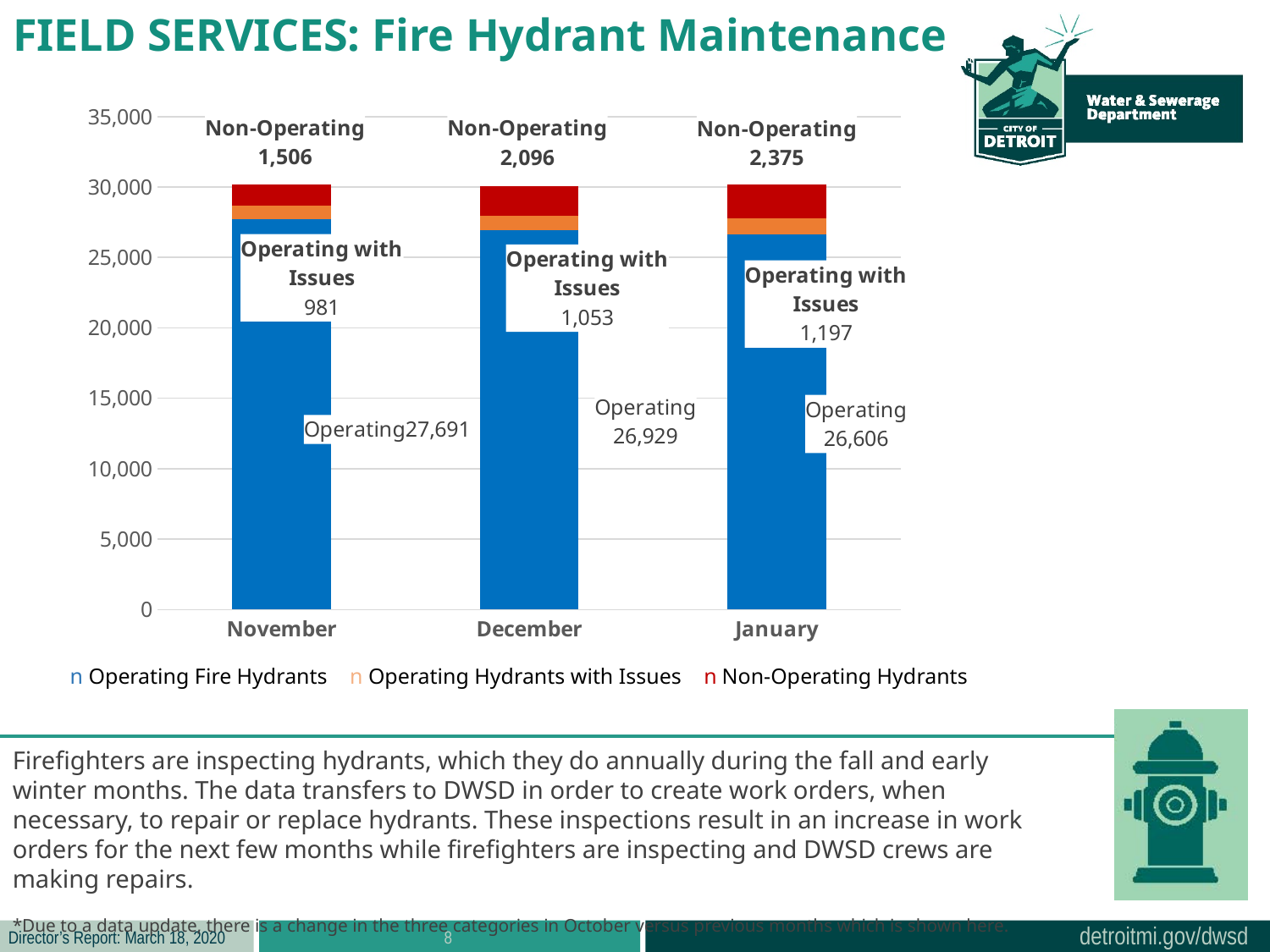
Do the Non-Operating hydrant values rise or fall from November to January? Rise Which month has the highest number of Non-Operating hydrants? January How many series does the chart legend list? 3 How many months are shown on the x axis of the chart? 3 Is the number of Operating with Issues hydrants larger in November or in January? January Which month has the lowest number of Operating fire hydrants? January What is the total number of hydrants in the December stacked bar? 30,078 How many Non-Operating hydrants are shown for January? 2,375 What is the difference in Non-Operating hydrants between January and November? 869 What is the value for Operating with Issues in December? 1,053 What is the number of Operating fire hydrants in November? 27,691 What type of chart is shown on the slide? Stacked bar chart